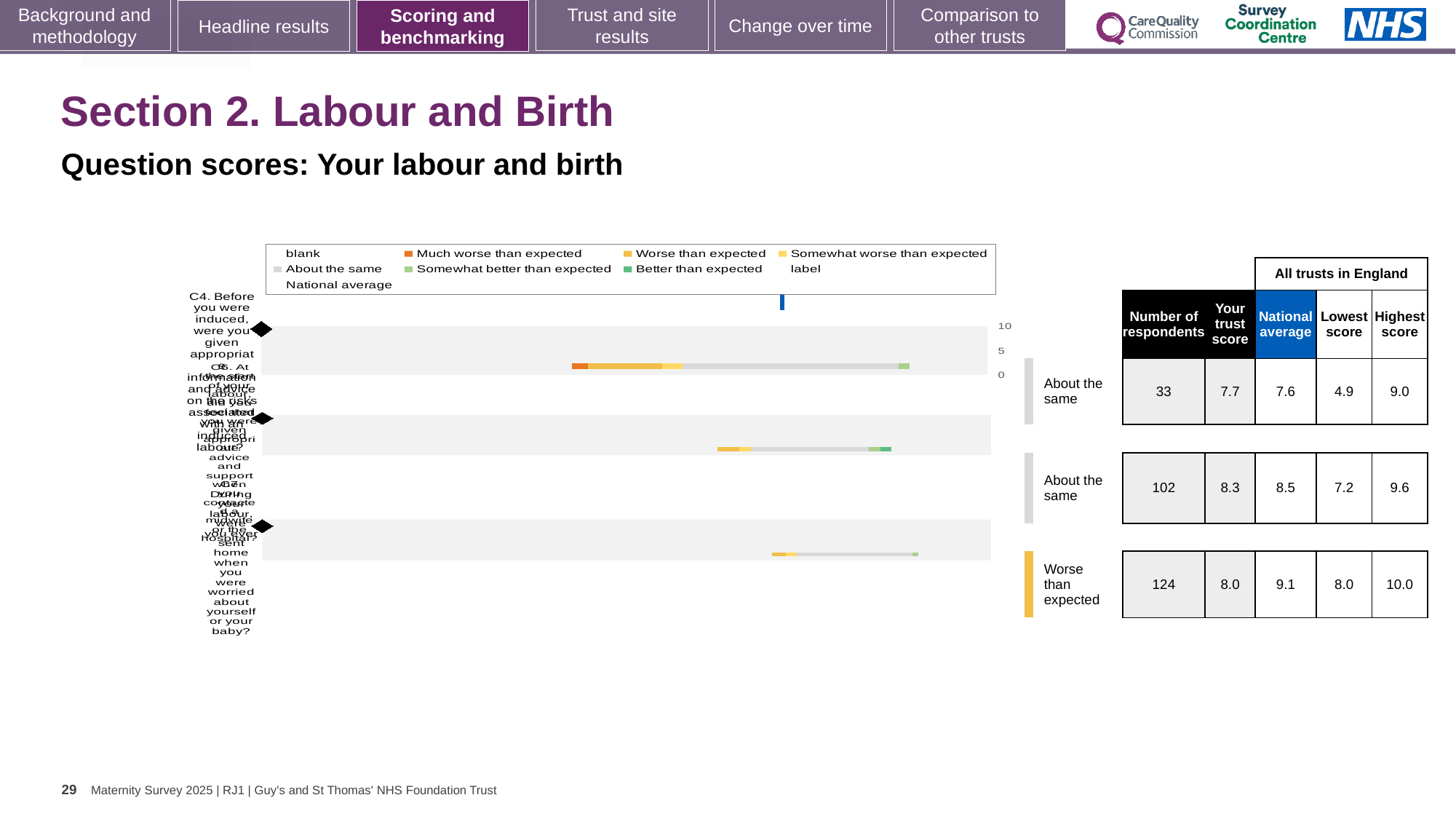
What is the national average for the third (bottom) question row? 9.1 What kind of chart is shown on the slide? bar chart What is the number of respondents for the first (top) question row? 33 What is the difference between the national average and the trust score for the third (bottom) question row? 1.1 What is the trust score for the second (middle) question row? 8.3 Which question row has the highest number of respondents? the third (bottom) row, 124 How many question rows (bars) are plotted in the chart? 3 How many entries does the chart legend list? 9 What benchmark category is shown for the first (top) question row? About the same Is the trust score for the first (top) question row larger or smaller than its national average? larger What benchmark category is shown for the third (bottom) question row? Worse than expected Which legend entry is shown in orange-red in the chart legend? Much worse than expected